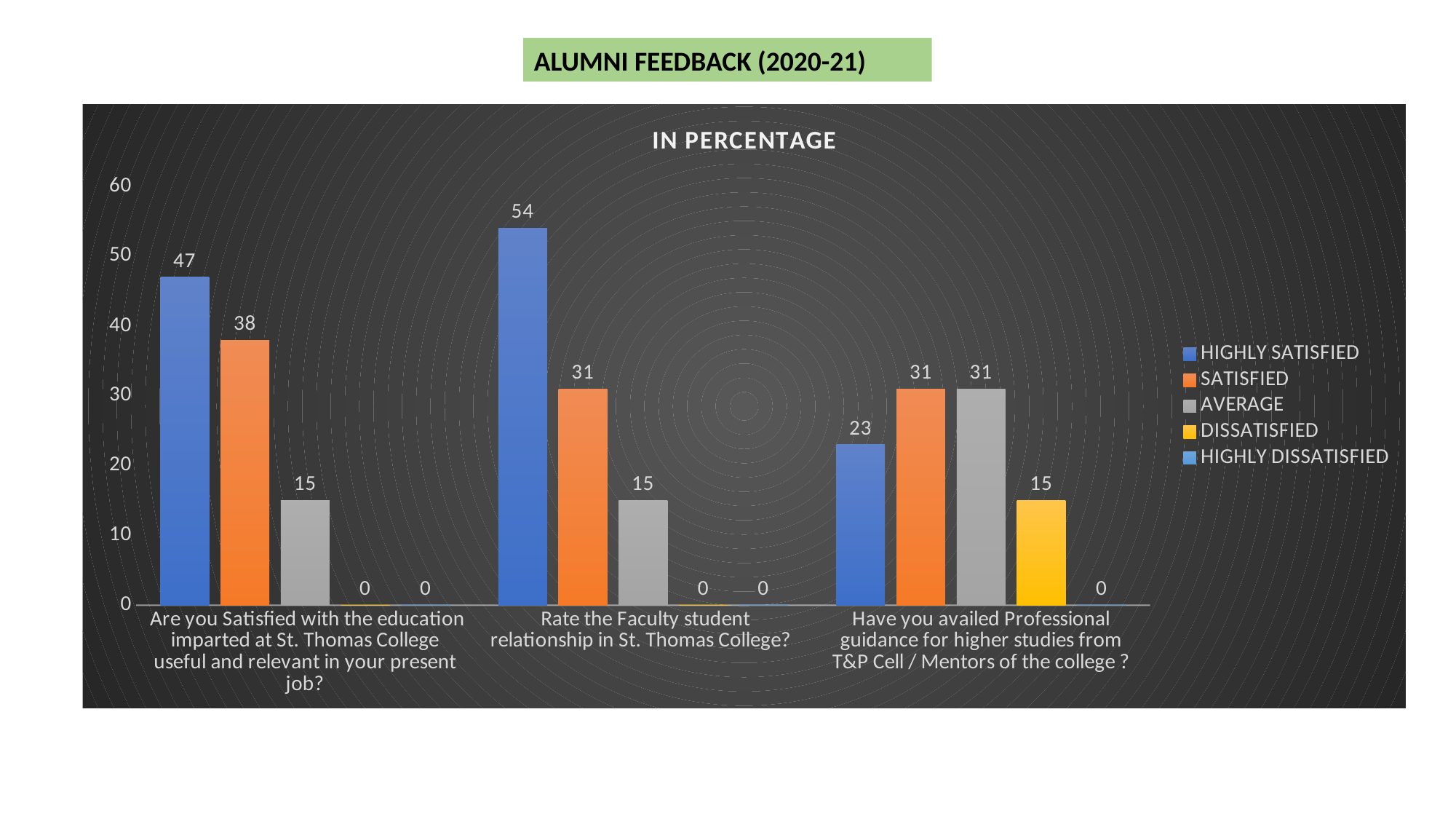
Which question has the highest HIGHLY SATISFIED value? Rate the Faculty student relationship in St. Thomas College? What kind of chart is shown on the slide? Bar chart How many series does the legend list? 5 What is the AVERAGE value for the question "Have you availed Professional guidance for higher studies from T&P Cell / Mentors of the college ?"? 31 What is the SATISFIED value for the question "Are you Satisfied with the education imparted at St. Thomas College useful and relevant in your present job?"? 38 What is the title of the chart? IN PERCENTAGE What is the DISSATISFIED value for the question "Have you availed Professional guidance for higher studies from T&P Cell / Mentors of the college ?"? 15 What is the difference between the HIGHLY SATISFIED and SATISFIED values for "Rate the Faculty student relationship in St. Thomas College?"? 23 How many questions (categories) are shown on the x axis? 3 What is the HIGHLY SATISFIED value for the question "Rate the Faculty student relationship in St. Thomas College?"? 54 Which question has the lowest HIGHLY SATISFIED value? Have you availed Professional guidance for higher studies from T&P Cell / Mentors of the college ? Which is larger for "Are you Satisfied with the education imparted at St. Thomas College useful and relevant in your present job?": HIGHLY SATISFIED or SATISFIED? HIGHLY SATISFIED